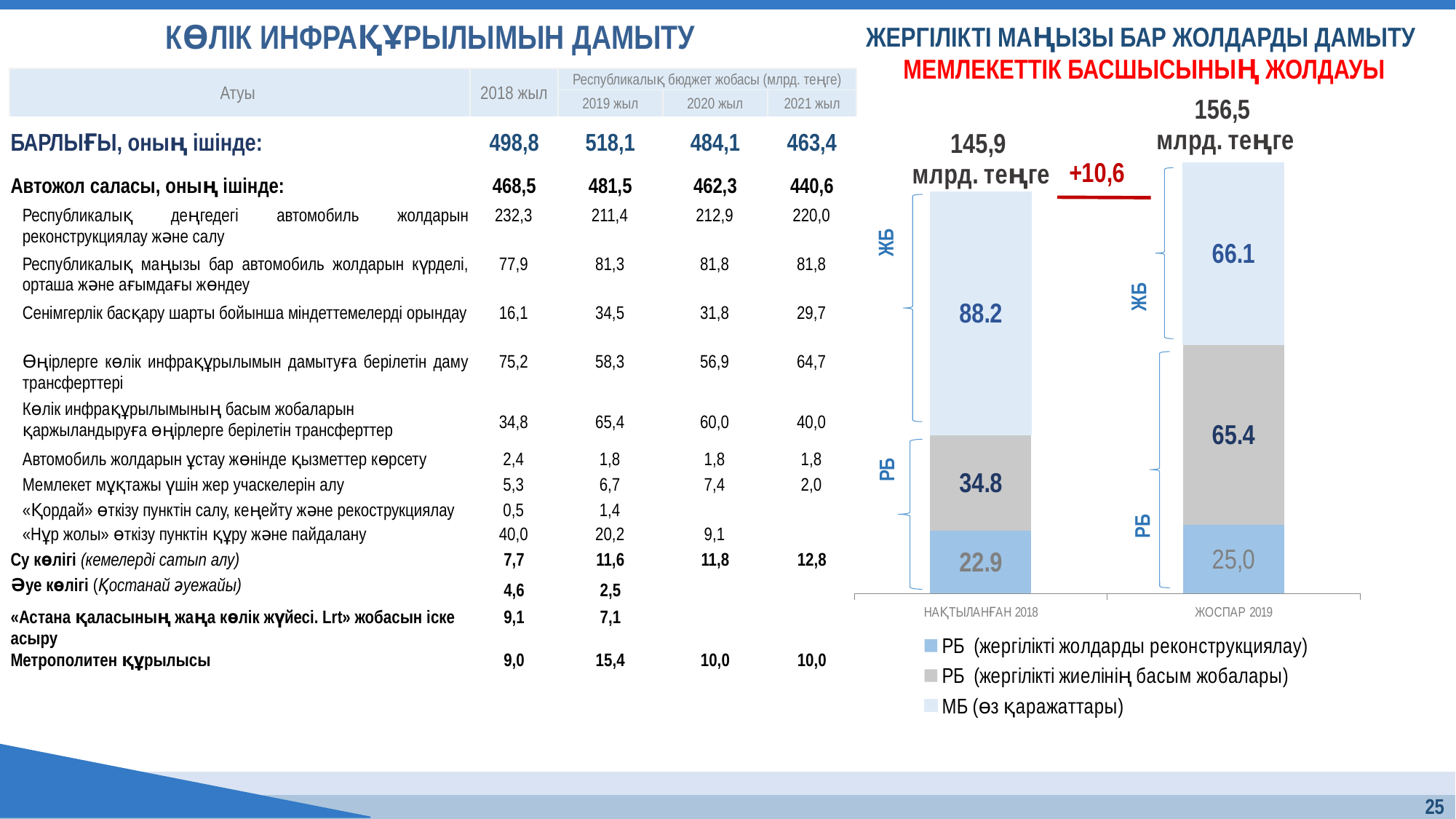
In the stacked bar chart, what is the value of the РБ (жергілікті жолдарды реконструкциялау) segment for НАҚТЫЛАНҒАН 2018? 22.9 In the stacked bar chart, what is the value of the МБ (өз қаражаттары) segment for ЖОСПАР 2019? 66.1 In the stacked bar chart, what is the difference between the ЖОСПАР 2019 total and the НАҚТЫЛАНҒАН 2018 total? +10,6 In the stacked bar chart, how many bars are plotted? 2 In the stacked bar chart, what is the total shown above the ЖОСПАР 2019 bar? 156,5 млрд. теңге In the stacked bar chart, which bar has the larger РБ (жергілікті жиелінің басым жобалары) segment, НАҚТЫЛАНҒАН 2018 or ЖОСПАР 2019? ЖОСПАР 2019 In the stacked bar chart, what is the value of the РБ (жергілікті жиелінің басым жобалары) segment for ЖОСПАР 2019? 65.4 What kind of chart is shown on the right side of the slide? stacked bar chart In the stacked bar chart, what is the difference between the МБ (өз қаражаттары) segments for НАҚТЫЛАНҒАН 2018 and ЖОСПАР 2019? 22.1 In the stacked bar chart, what is the total shown above the НАҚТЫЛАНҒАН 2018 bar? 145,9 млрд. теңге In the stacked bar chart, how many series does the legend list? 3 In the stacked bar chart, what is the value of the МБ (өз қаражаттары) segment for НАҚТЫЛАНҒАН 2018? 88.2